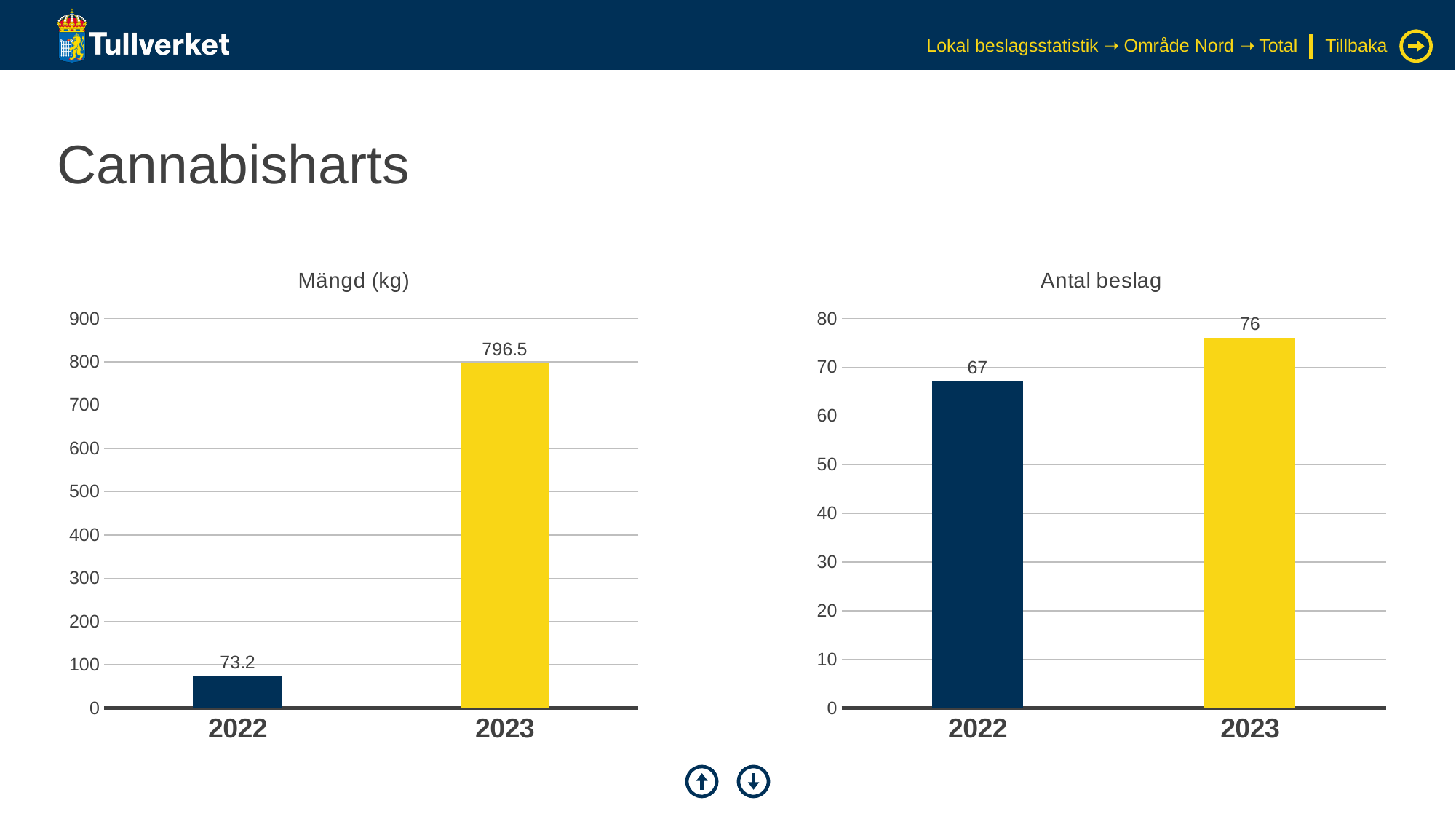
In the 'Mängd (kg)' chart, which year has the highest value? 2023 In the 'Mängd (kg)' chart, what is the difference between the values for 2023 and 2022? 723.3 In the 'Mängd (kg)' chart, what is the value for 2022? 73.2 In the 'Antal beslag' chart, which year has the lowest value? 2022 What kind of chart is the 'Mängd (kg)' chart? bar chart In the 'Mängd (kg)' chart, is the value for 2022 greater or less than 100? less How many categories are shown on the x axis of the 'Antal beslag' chart? 2 In the 'Mängd (kg)' chart, what is the value for 2023? 796.5 In the 'Antal beslag' chart, what is the value for 2022? 67 In the 'Antal beslag' chart, what is the difference between the values for 2023 and 2022? 9 In the 'Antal beslag' chart, what is the value for 2023? 76 In the 'Antal beslag' chart, is the value for 2023 greater or less than 70? greater